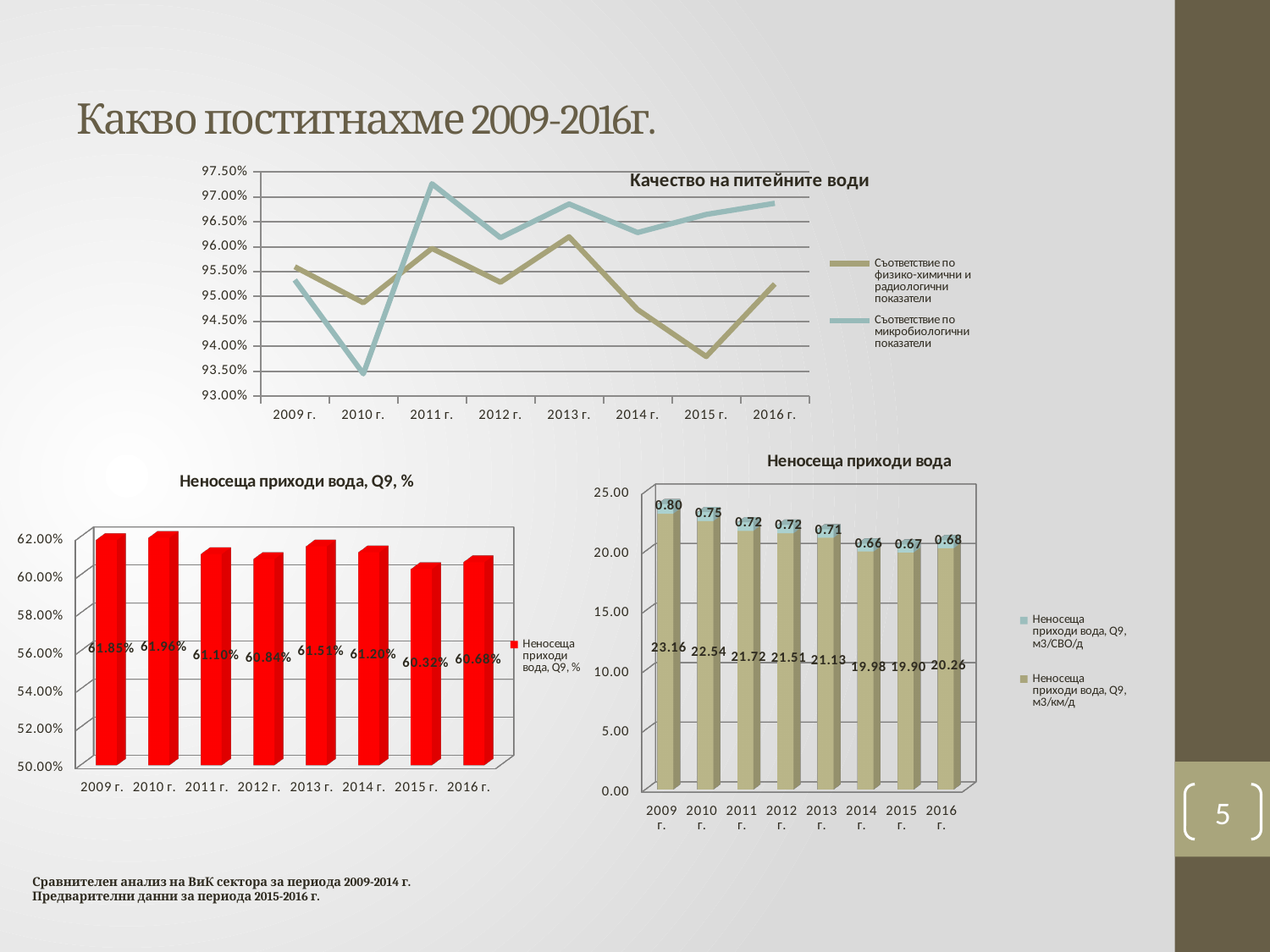
In the chart titled 'Неносеща приходи вода' (bottom right), which year has the highest value of 'Неносеща приходи вода, Q9, м3/км/д'? 2009 In the chart titled 'Неносеща приходи вода, Q9, %', which year has the lowest value? 2015 г. In the chart titled 'Качество на питейните води', is the value of 'Съответствие по микробиологични показатели' for 2010 г. greater or less than 94.00%? less In the chart titled 'Неносеща приходи вода, Q9, %', what is the difference between the values for 2010 г. and 2015 г.? 1.64% In the chart titled 'Неносеща приходи вода, Q9, %', what is the value for 2009 г.? 61.85% In the chart titled 'Неносеща приходи вода' (bottom right), how many series does the legend list? 2 In the chart titled 'Неносеща приходи вода' (bottom right), what is the total of the stacked bar for 2009? 23.96 In the chart titled 'Качество на питейните води', is the value of 'Съответствие по микробиологични показатели' for 2011 г. greater or less than 97.00%? greater What kind of chart is the chart titled 'Качество на питейните води'? line chart In the chart titled 'Неносеща приходи вода' (bottom right), what is the value of 'Неносеща приходи вода, Q9, м3/км/д' for 2012? 21.51 In the chart titled 'Неносеща приходи вода, Q9, %', which year has the highest value? 2010 г. In the chart titled 'Неносеща приходи вода' (bottom right), what is the value of 'Неносеща приходи вода, Q9, м3/СВО/д' for 2014? 0.66